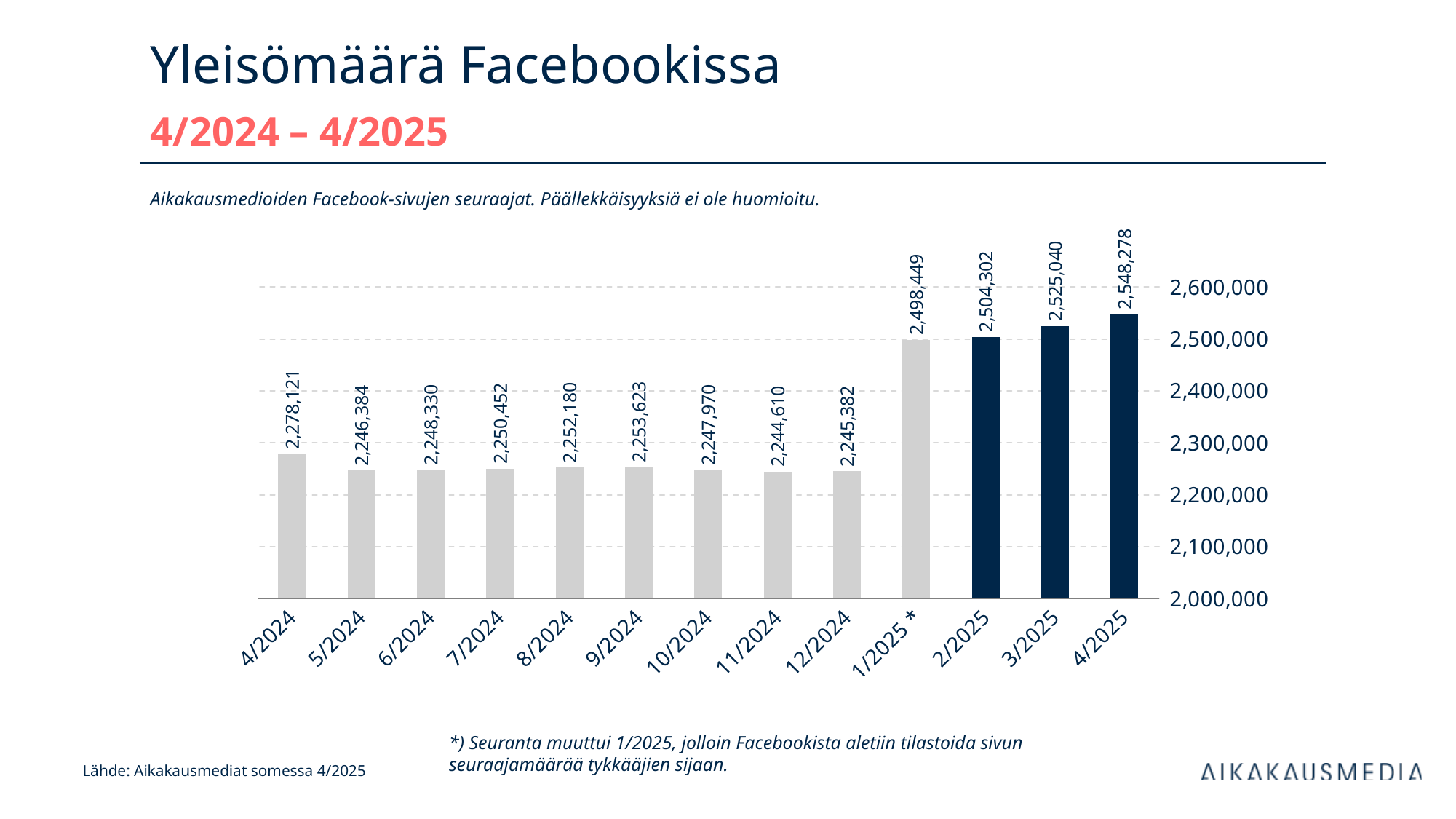
How many months are shown on the x axis? 13 What kind of chart is shown on the slide? Bar chart Which is larger, the value for 4/2024 or the value for 5/2024? 4/2024 Is the value for 7/2024 greater or less than 2,300,000? less What is the value for 1/2025 *? 2,498,449 What is the value for 4/2025? 2,548,278 What is the value for 4/2024? 2,278,121 Which month has the highest value? 4/2025 What is the difference between the values for 1/2025 * and 12/2024? 253,067 Do the values overall rise or fall from 4/2024 to 4/2025? Rise Which month has the lowest value? 11/2024 What is the difference between the values for 4/2025 and 4/2024? 270,157